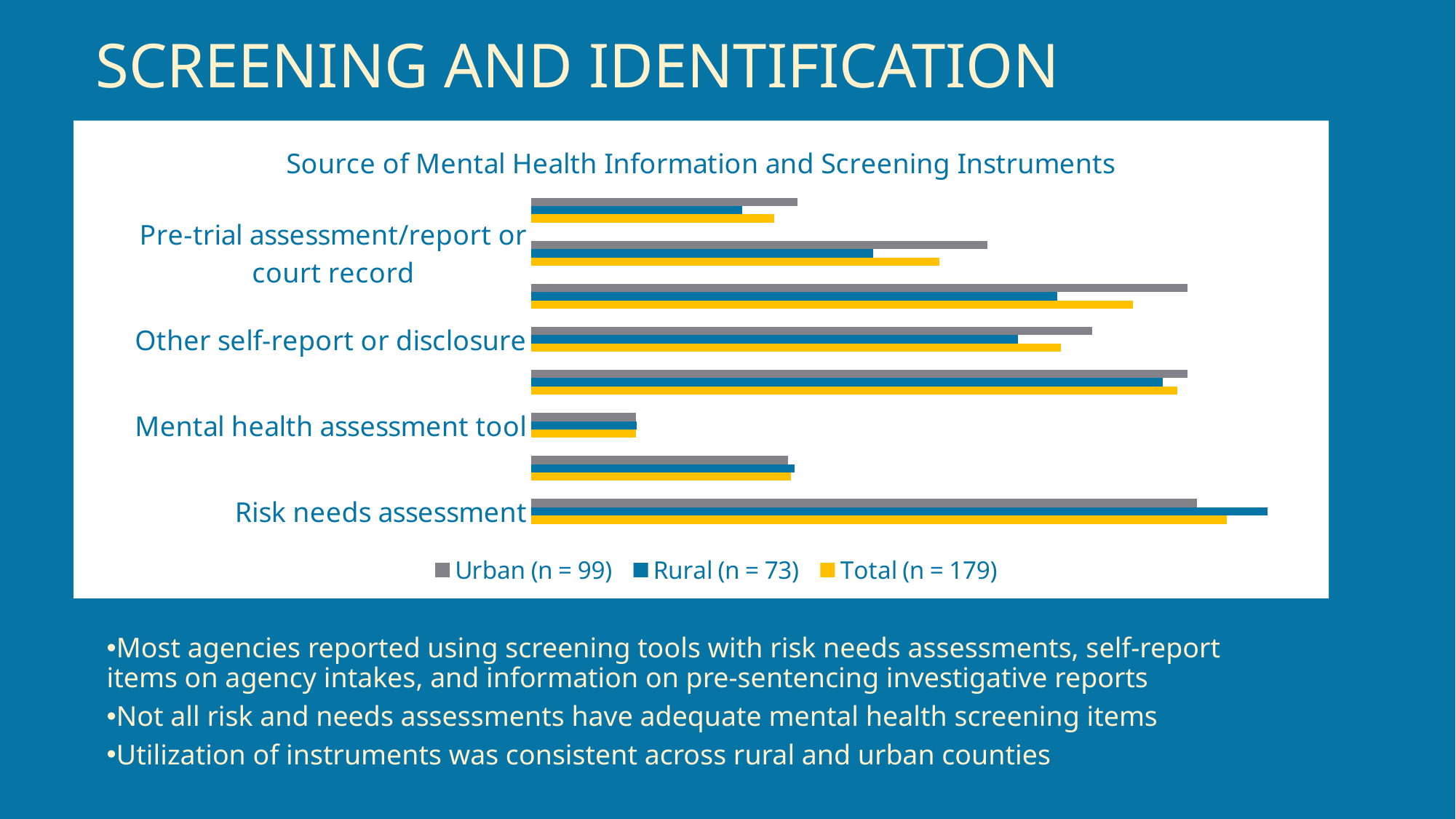
Which is larger: the Urban bar for Other self-report or disclosure or the Urban bar for Pre-trial assessment/report or court record? Other self-report or disclosure For Risk needs assessment, which is larger: the Urban bar or the Rural bar? Rural Which series is shown in yellow in the legend? Total (n = 179) Among the labelled categories, which has the longest Rural bar? Risk needs assessment How many series does the legend list? 3 For Other self-report or disclosure, which is larger: the Urban bar or the Rural bar? Urban What is the title of the chart? Source of Mental Health Information and Screening Instruments Among the labelled categories, which has the shortest Urban bar? Mental health assessment tool Among the labelled categories, which has the longest Total bar? Risk needs assessment What kind of chart is shown on the slide? Bar chart